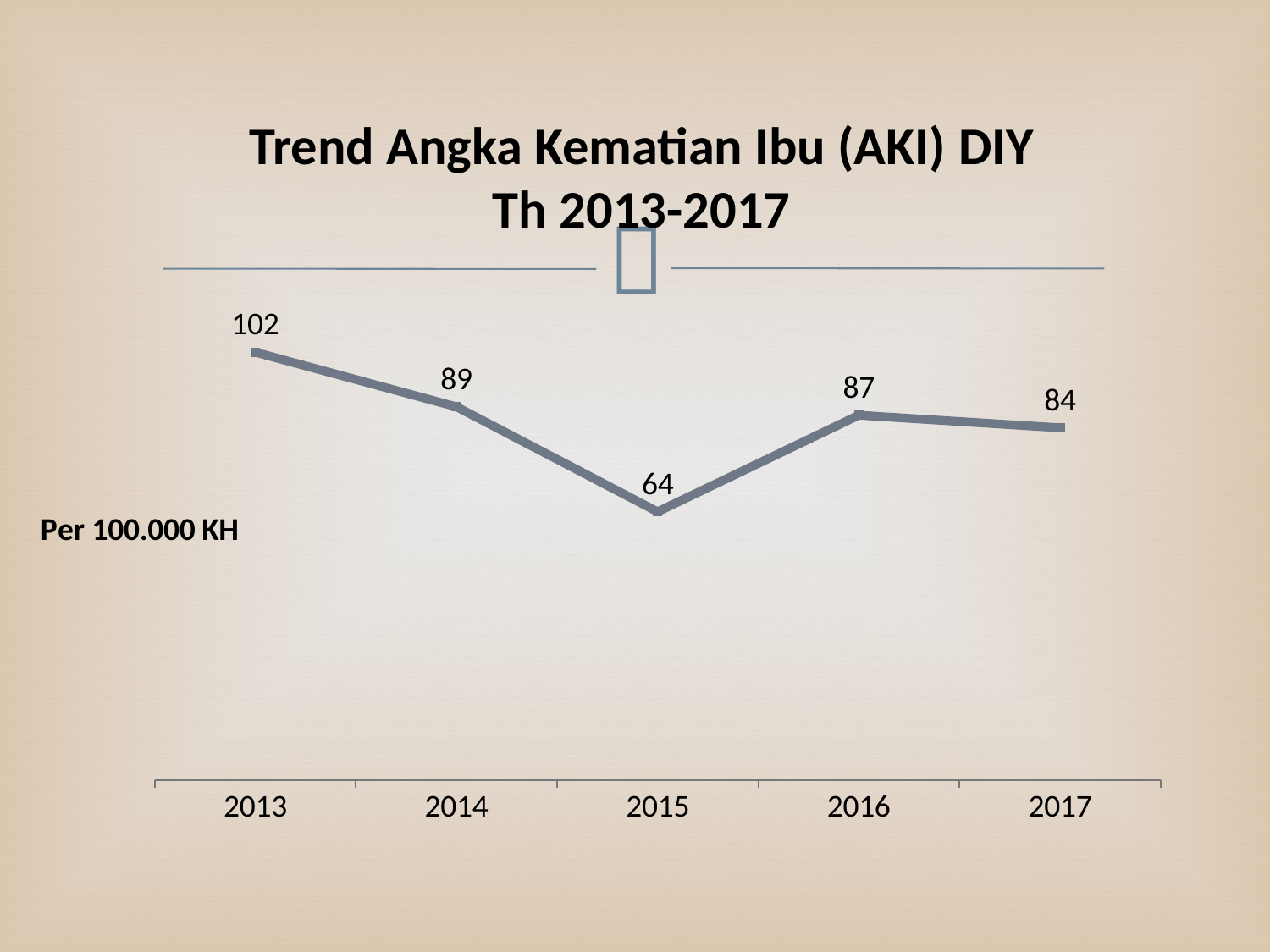
Does the value rise or fall from 2013 to 2015? fall What is the value for 2013? 102 What is the value for 2017? 84 Which year has the highest value? 2013 What is the difference between the values for 2016 and 2017? 3 Which year has the lowest value? 2015 What is the value for 2015? 64 What is the title of the chart? Trend Angka Kematian Ibu (AKI) DIY Th 2013-2017 How many years are plotted on the chart? 5 What kind of chart is shown on the slide? line chart Which is larger, the value for 2014 or the value for 2016? 2014 What is the difference between the values for 2013 and 2015? 38